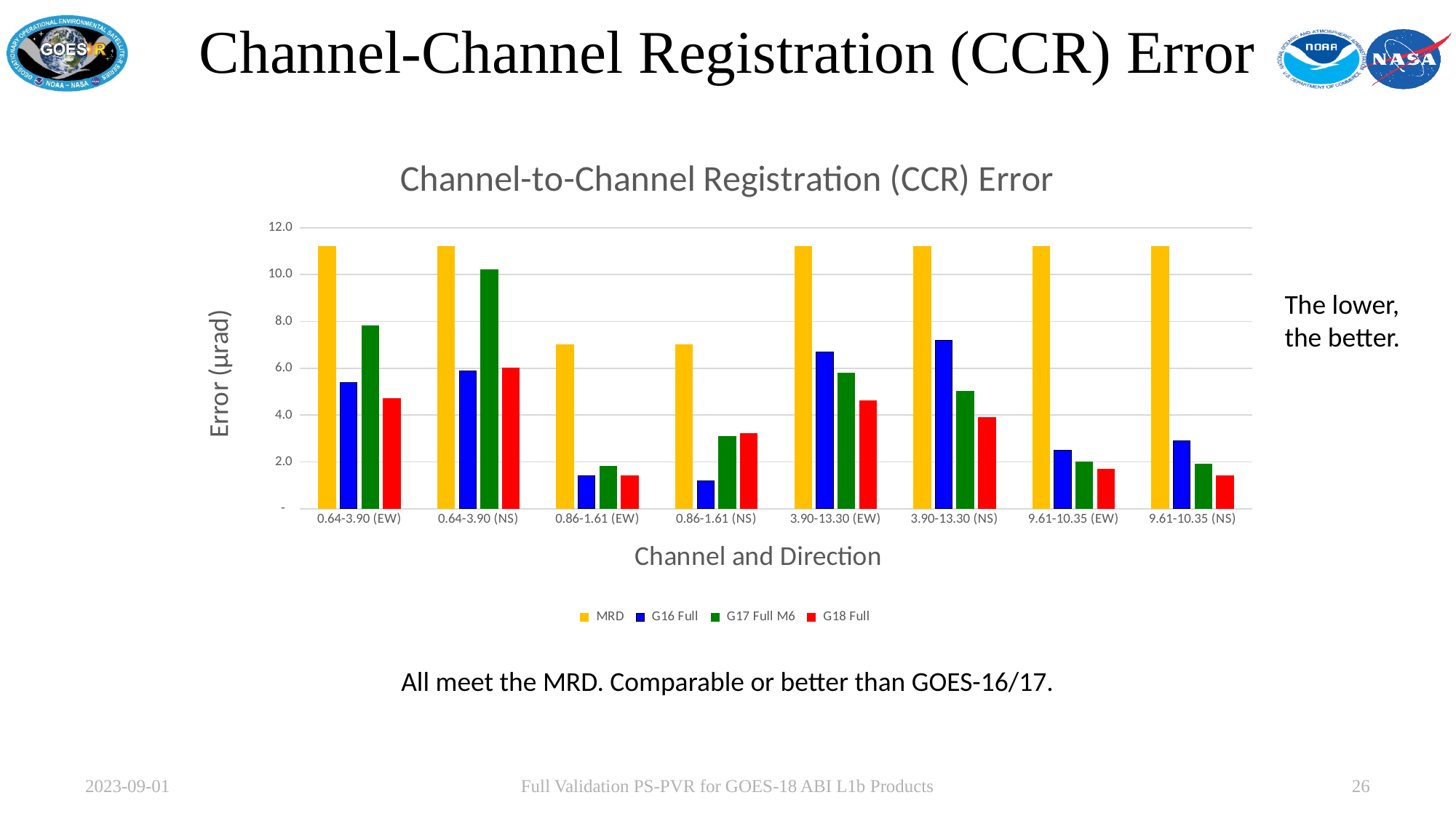
Which series has the lowest value for 3.90-13.30 (NS)? G18 Full How many series does the legend list? 4 Is the G17 Full M6 value for 0.64-3.90 (NS) greater or less than 8.0? greater How many channel-and-direction categories are shown on the x axis? 8 What kind of chart is shown on the slide? bar chart What is the title of the x axis? Channel and Direction Which series has the highest value for 0.64-3.90 (EW)? MRD For 3.90-13.30 (EW), which is larger: G16 Full or G17 Full M6? G16 Full For 9.61-10.35 (EW), which is larger: G16 Full or G18 Full? G16 Full Is the MRD value for 0.86-1.61 (EW) greater or less than 8.0? less What is the title of the y axis? Error (μrad) Is the G16 Full value for 0.86-1.61 (NS) greater or less than 2.0? less